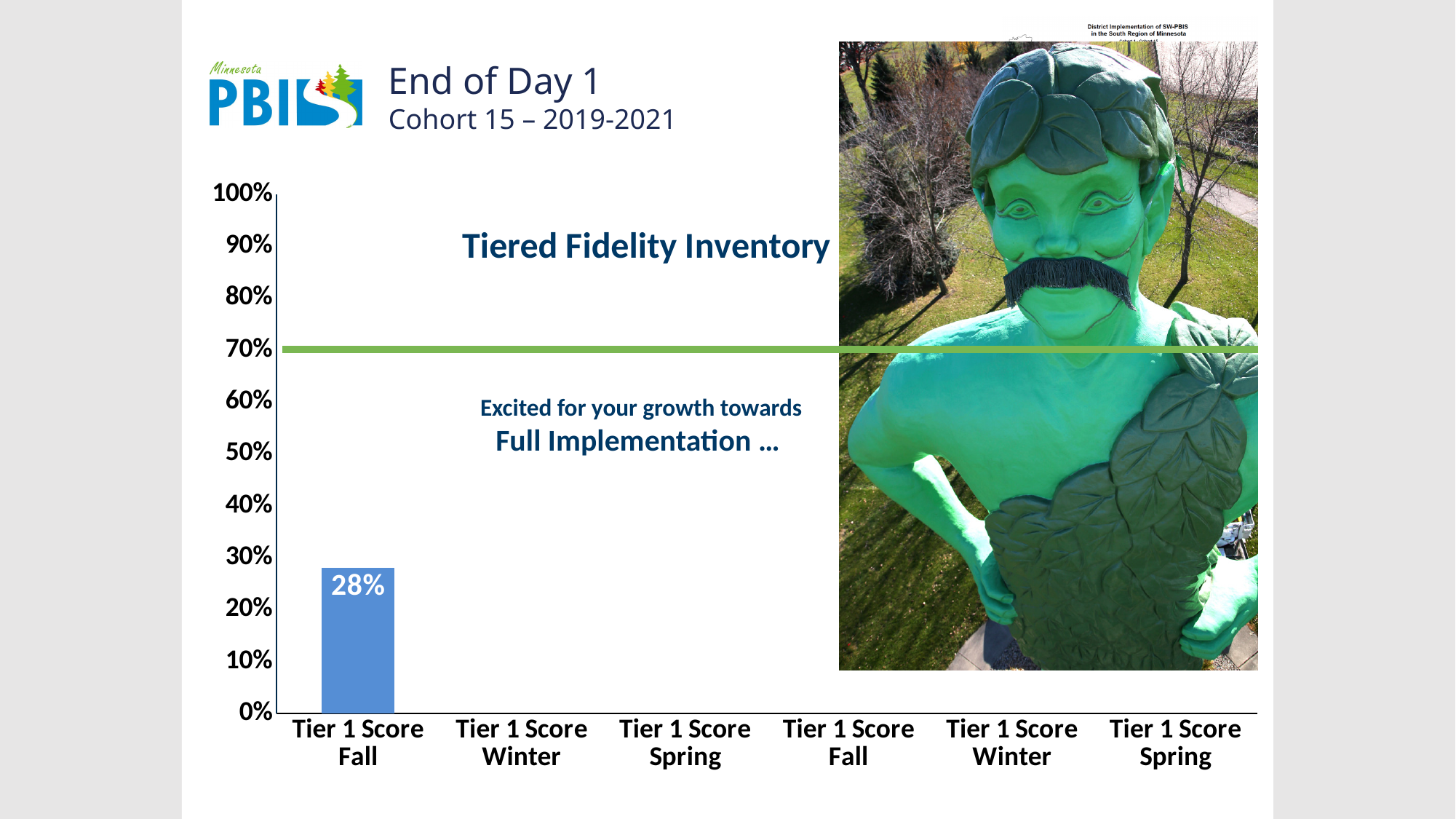
How many categories are listed along the x axis of the chart? 6 How many bars are actually plotted in the chart? 1 What is the value of the first Tier 1 Score Fall bar? 28% What kind of chart is shown on the slide? bar chart Is the value for the first Tier 1 Score Fall bar greater or less than 30%? less At what percentage is the green horizontal line drawn across the chart? 70% Is the value for the first Tier 1 Score Fall bar greater or less than 20%? greater What is the title of the chart? Tiered Fidelity Inventory Is the first Tier 1 Score Fall bar above or below the green horizontal line? below What is the highest value shown on the y axis of the chart? 100% Which category is the only one with a plotted bar? Tier 1 Score Fall (first)